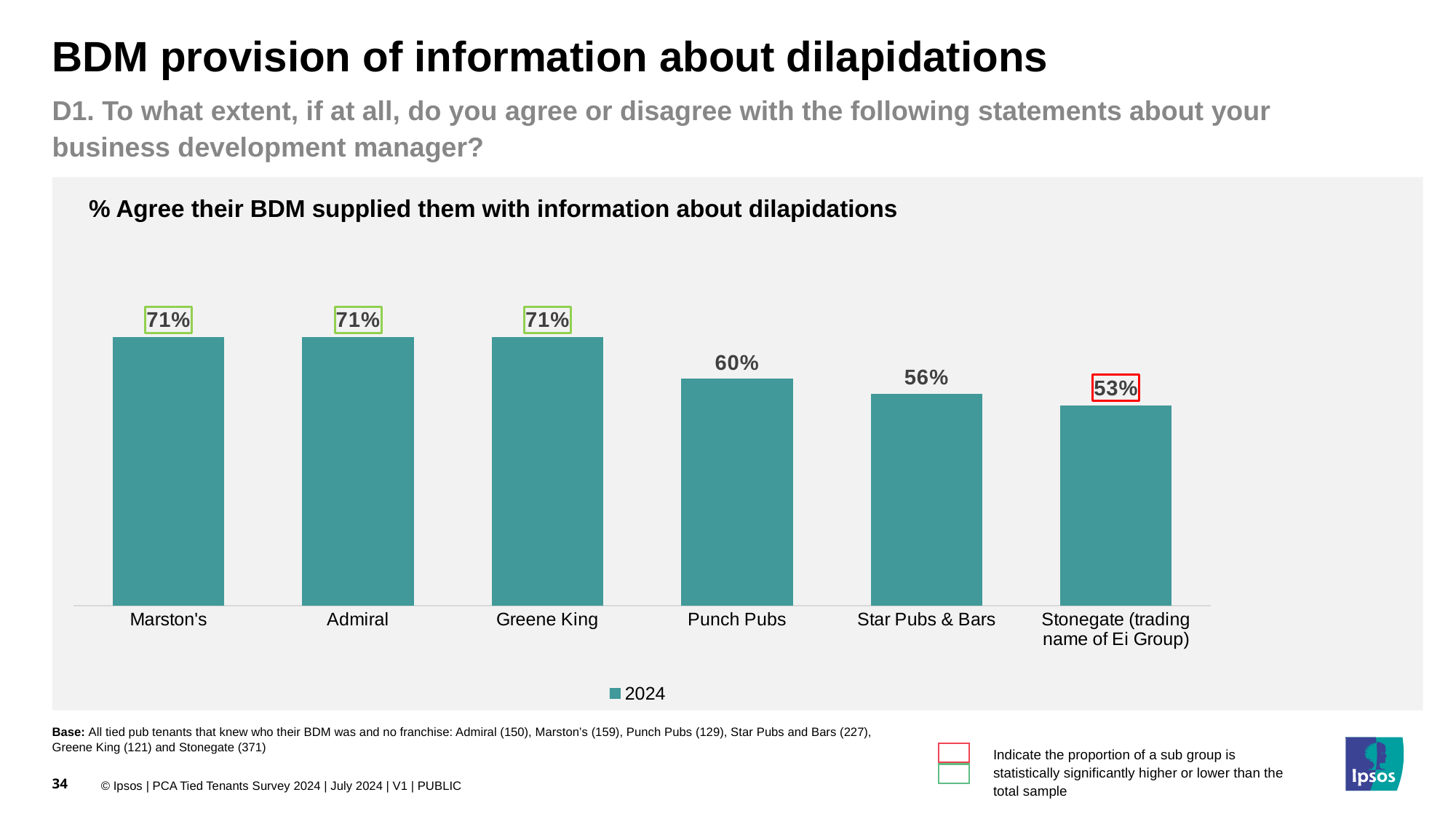
What is the difference in percentage points between Marston's and Stonegate (trading name of Ei Group)? 18 percentage points What percentage of Punch Pubs tenants agree their BDM supplied them with information about dilapidations? 60% Which pub company has the lowest percentage agreeing their BDM supplied information about dilapidations? Stonegate (trading name of Ei Group) What is the value shown for Star Pubs & Bars? 56% What type of chart is shown on the slide? Bar chart What is the difference in percentage points between Punch Pubs and Star Pubs & Bars? 4 percentage points Which year does the legend show for the data series? 2024 How many pub companies are shown on the chart? 6 Which has a higher value, Greene King or Punch Pubs? Greene King What is the value shown for Admiral? 71% What is the value shown for Stonegate (trading name of Ei Group)? 53% Which has a higher value, Star Pubs & Bars or Stonegate (trading name of Ei Group)? Star Pubs & Bars